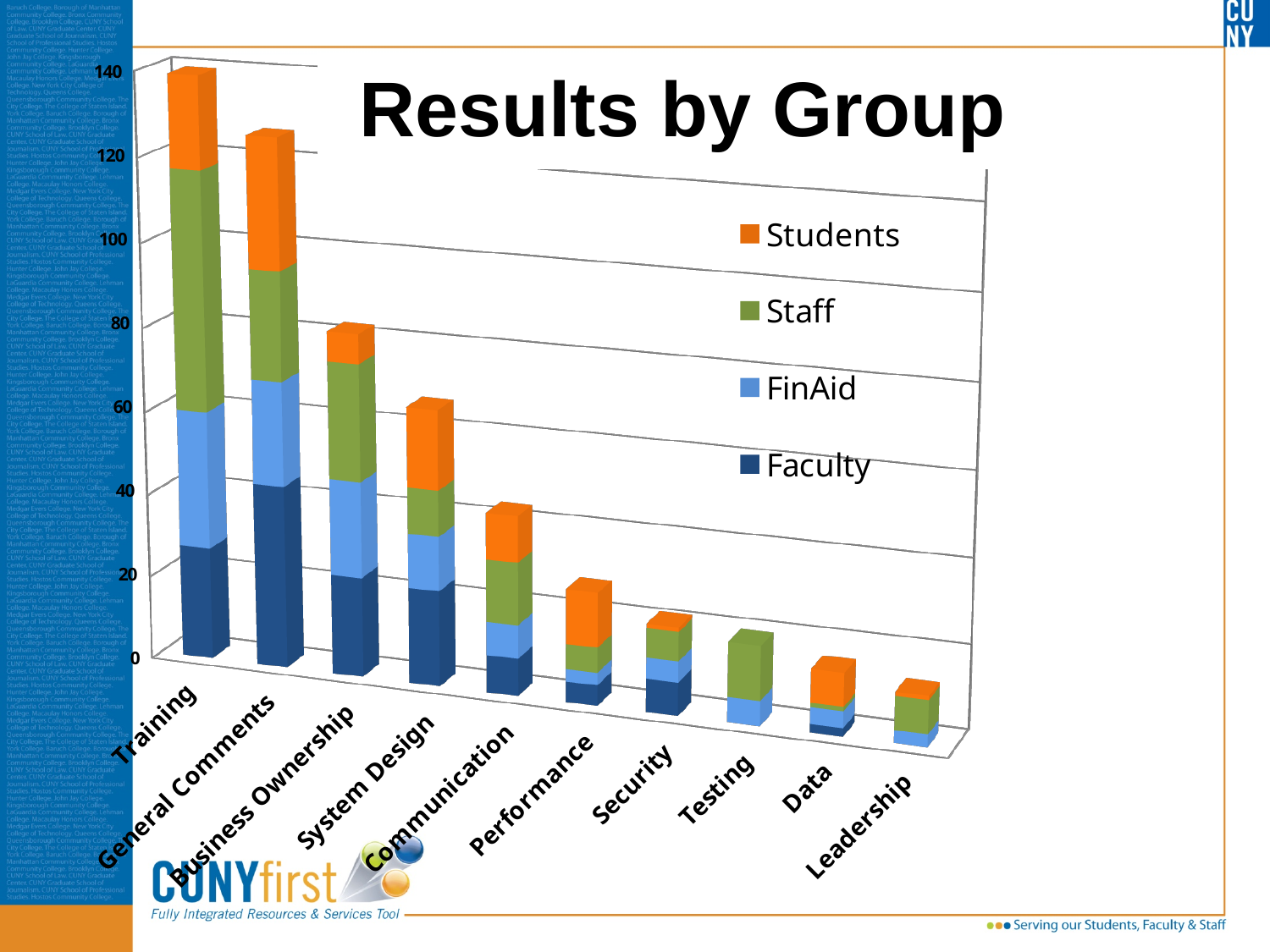
Is the total for Training greater or less than 100? greater Which has a larger total, Business Ownership or Security? Business Ownership Do the totals rise or fall moving from Training to Leadership along the x axis? fall Is the total for Leadership greater or less than 20? less How many series does the legend list? 4 How many categories are shown on the x axis? 10 What is the title of the chart? Results by Group Which category has the lowest total? Leadership Which series are listed in the legend? Students, Staff, FinAid, Faculty Which category has the highest total? Training Which has a larger total, Training or Leadership? Training What kind of chart is shown on the slide? Stacked bar chart